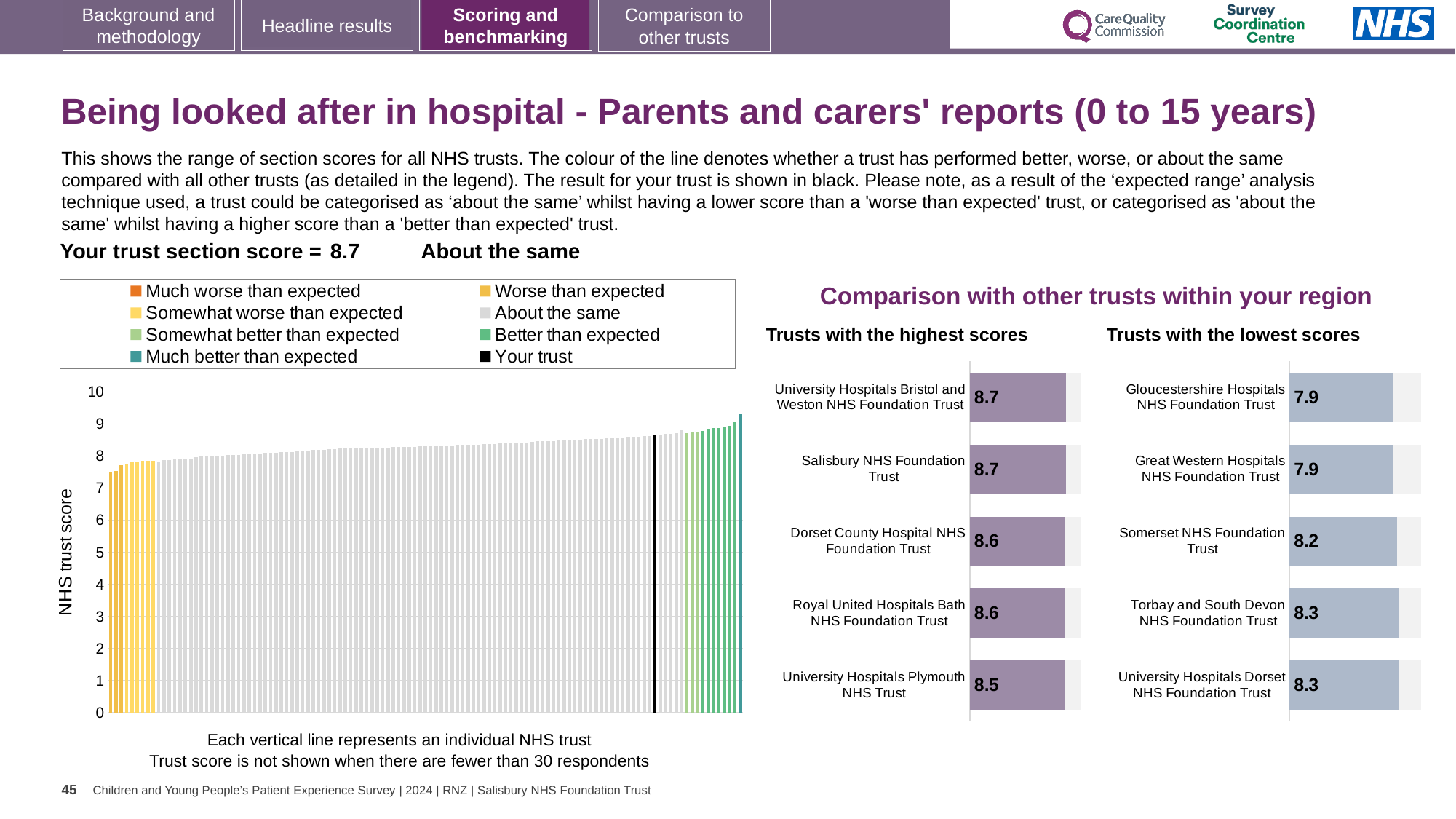
In the 'Trusts with the lowest scores' chart, how many trusts are listed? 5 In the large chart on the left showing all NHS trusts, do the bar values rise or fall from left to right? rise In the 'Trusts with the lowest scores' chart, what is the score for Somerset NHS Foundation Trust? 8.2 In the large chart on the left showing all NHS trusts, is the value of the lowest bar greater or less than 8? less In the 'Trusts with the lowest scores' chart, what is the difference between the scores of Somerset NHS Foundation Trust and Gloucestershire Hospitals NHS Foundation Trust? 0.3 In the 'Trusts with the highest scores' chart, what is the score for Salisbury NHS Foundation Trust? 8.7 In the 'Trusts with the highest scores' chart, which trust has the lowest score shown? University Hospitals Plymouth NHS Trust What kind of chart is the large chart on the left showing all NHS trusts? bar chart How many entries does the legend above the large chart on the left list? 8 In the 'Trusts with the highest scores' chart, what is the score for University Hospitals Plymouth NHS Trust? 8.5 In the 'Trusts with the lowest scores' chart, which trust has the highest score shown? Torbay and South Devon NHS Foundation Trust and University Hospitals Dorset NHS Foundation Trust (8.3) In the 'Trusts with the highest scores' chart, which has the larger score: Dorset County Hospital NHS Foundation Trust or University Hospitals Plymouth NHS Trust? Dorset County Hospital NHS Foundation Trust